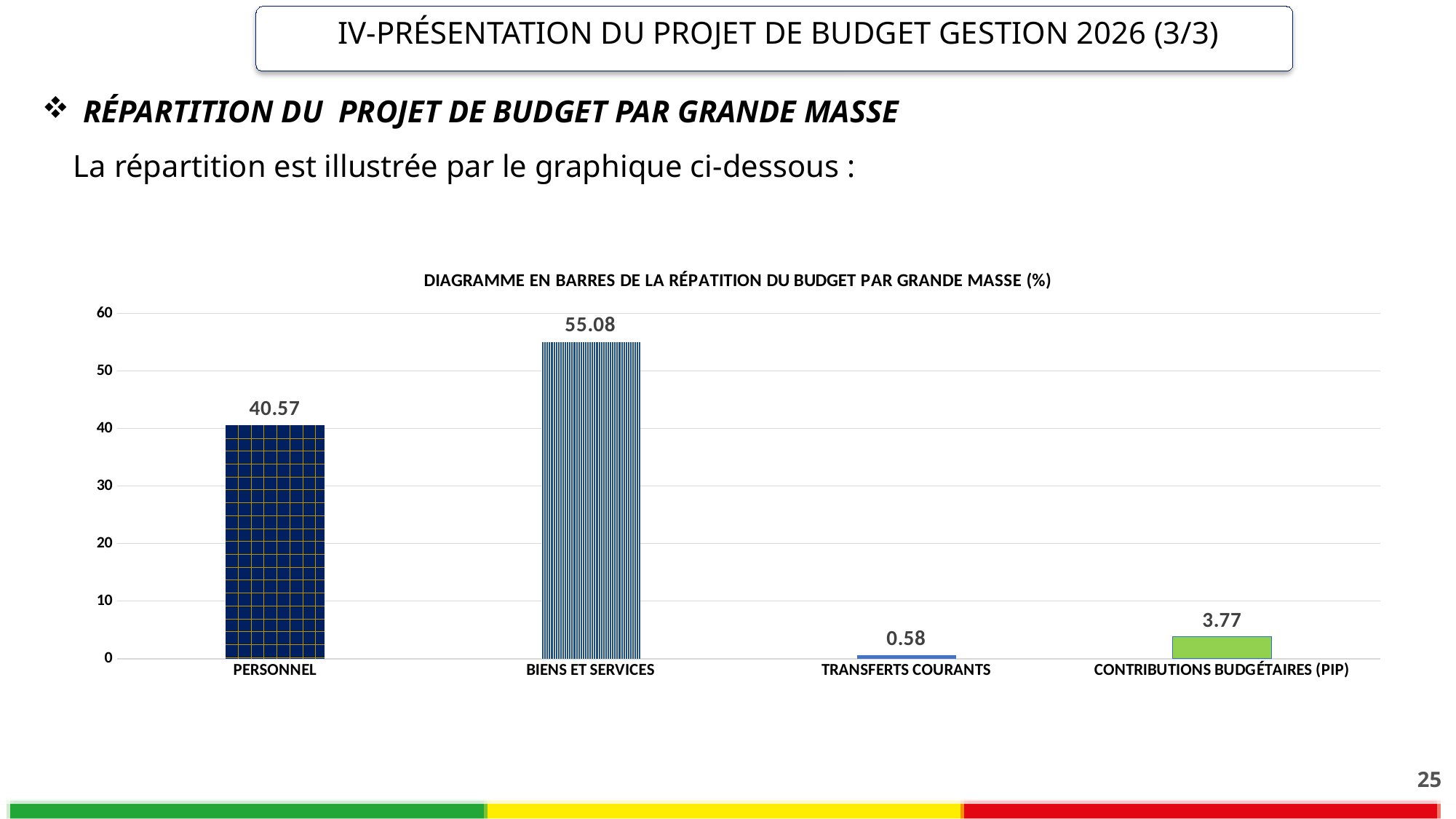
Is the value for PERSONNEL greater or less than 50? less Which category has the highest value? BIENS ET SERVICES How many categories are shown in the chart? 4 What is the title of the chart? DIAGRAMME EN BARRES DE LA RÉPATITION DU BUDGET PAR GRANDE MASSE (%) What is the difference between the values for BIENS ET SERVICES and PERSONNEL? 14.51 What is the value for CONTRIBUTIONS BUDGÉTAIRES (PIP)? 3.77 Which category has the lowest value? TRANSFERTS COURANTS Which is larger, the value for CONTRIBUTIONS BUDGÉTAIRES (PIP) or the value for TRANSFERTS COURANTS? CONTRIBUTIONS BUDGÉTAIRES (PIP) What kind of chart is shown on the slide? bar chart What is the value for PERSONNEL? 40.57 What is the value for BIENS ET SERVICES? 55.08 What is the value for TRANSFERTS COURANTS? 0.58